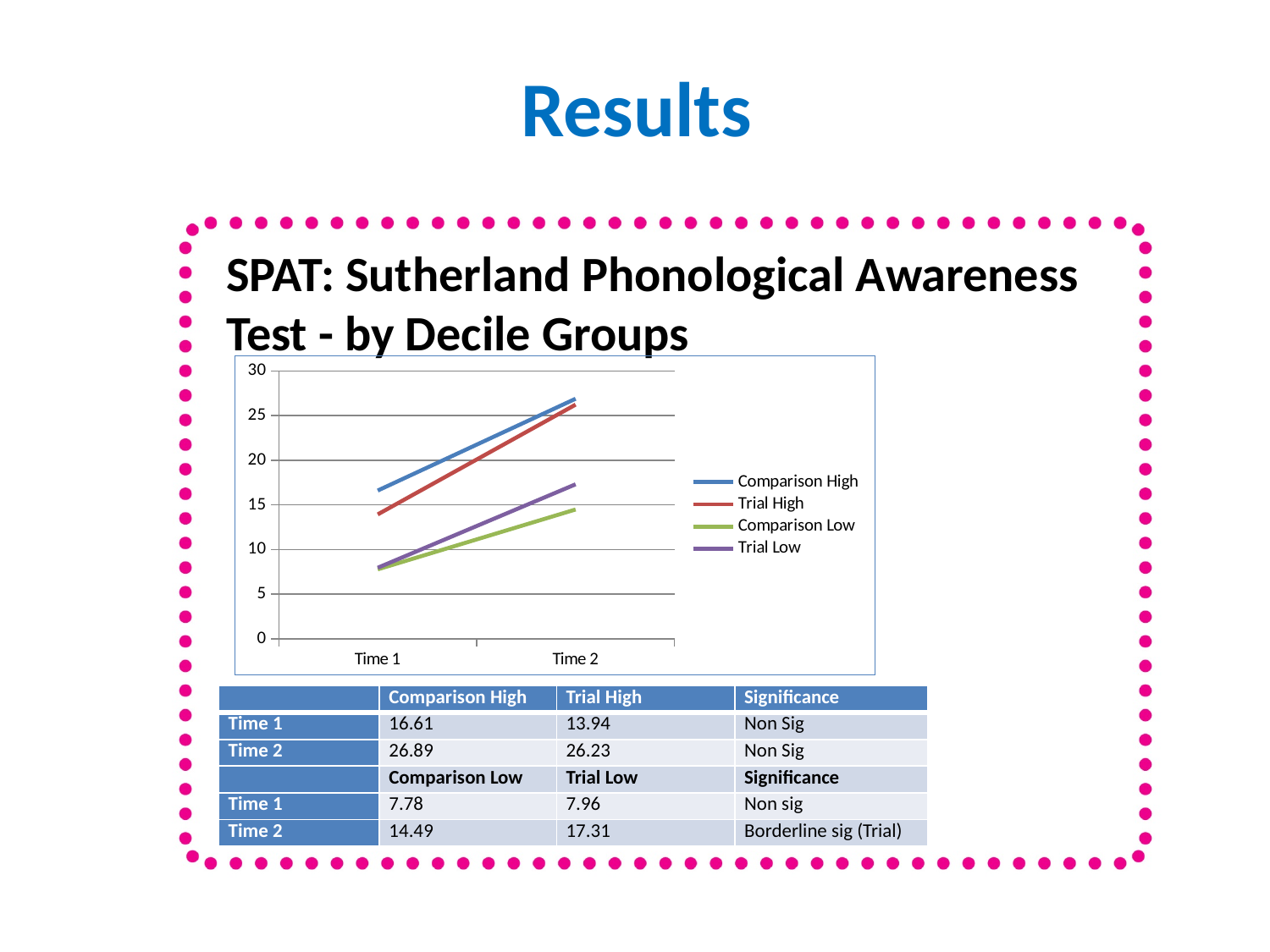
What is the value for Trial Low at Time 2? 17.31 Which series has the highest value at Time 2? Comparison High Is the value for Comparison High at Time 2 greater or less than 25? greater What kind of chart is shown on the slide? Line chart How many series does the chart legend list? 4 What is the difference between Trial Low and Comparison Low at Time 2? 2.82 What is the value for Trial High at Time 2? 26.23 Do the values for Trial High rise or fall from Time 1 to Time 2? Rise Which series has the lowest value at Time 2? Comparison Low How many time points are shown on the x axis of the chart? 2 Which colour is used for the Trial Low line in the chart? Purple What is the value for Comparison High at Time 1? 16.61